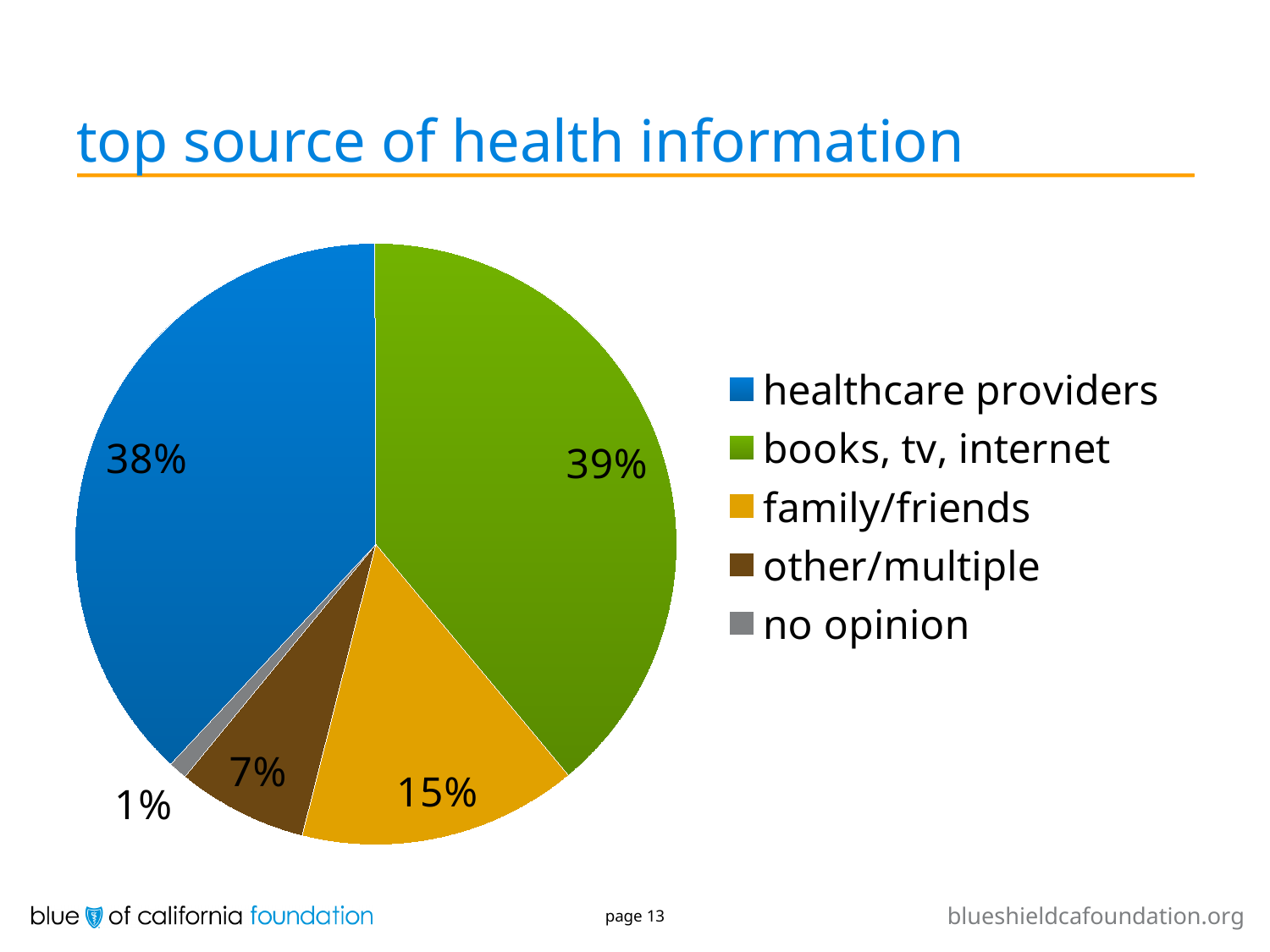
What is the difference in percentage points between books, tv, internet and healthcare providers? 1 What share of the pie is labelled for family/friends? 15% What share of the pie is labelled for no opinion? 1% What kind of chart is shown on the slide? pie chart What is the title of the chart? top source of health information What is the difference in percentage points between family/friends and other/multiple? 8 What share of the pie is labelled for other/multiple? 7% How many categories does the pie chart show? 5 Which is larger, the slice for family/friends or the slice for other/multiple? family/friends Which category has the smallest slice of the pie? no opinion What share of the pie is labelled for healthcare providers? 38% What share of the pie is labelled for books, tv, internet? 39%